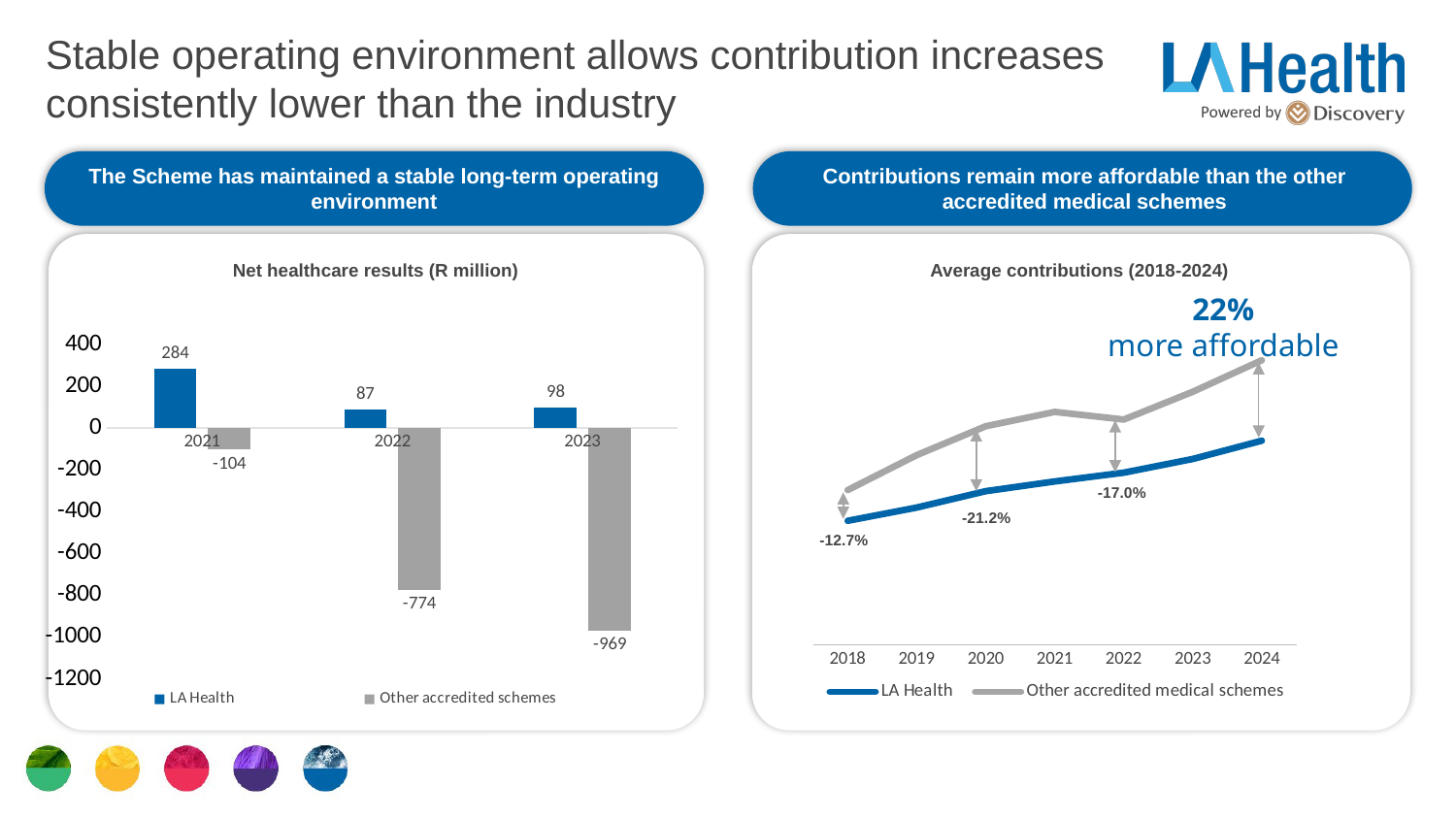
In the 'Net healthcare results (R million)' chart, is the LA Health value for 2023 larger or smaller than its value for 2022? larger In the 'Net healthcare results (R million)' chart, what is the difference between the LA Health value and the Other accredited schemes value in 2021? 388 In the 'Net healthcare results (R million)' chart, what is the value for Other accredited schemes in 2023? -969 What kind of chart is the 'Average contributions (2018-2024)' chart? line chart What kind of chart is the 'Net healthcare results (R million)' chart? bar chart In the 'Average contributions (2018-2024)' chart, what percentage difference is labelled for 2020? -21.2% In the 'Net healthcare results (R million)' chart, what is the value for LA Health in 2021? 284 In the 'Net healthcare results (R million)' chart, how many series does the legend list? 2 In the 'Net healthcare results (R million)' chart, which year has the highest value for LA Health? 2021 In the 'Net healthcare results (R million)' chart, which year has the lowest value for Other accredited schemes? 2023 In the 'Net healthcare results (R million)' chart, what is the value for Other accredited schemes in 2022? -774 In the 'Average contributions (2018-2024)' chart, how many years are shown on the x axis? 7